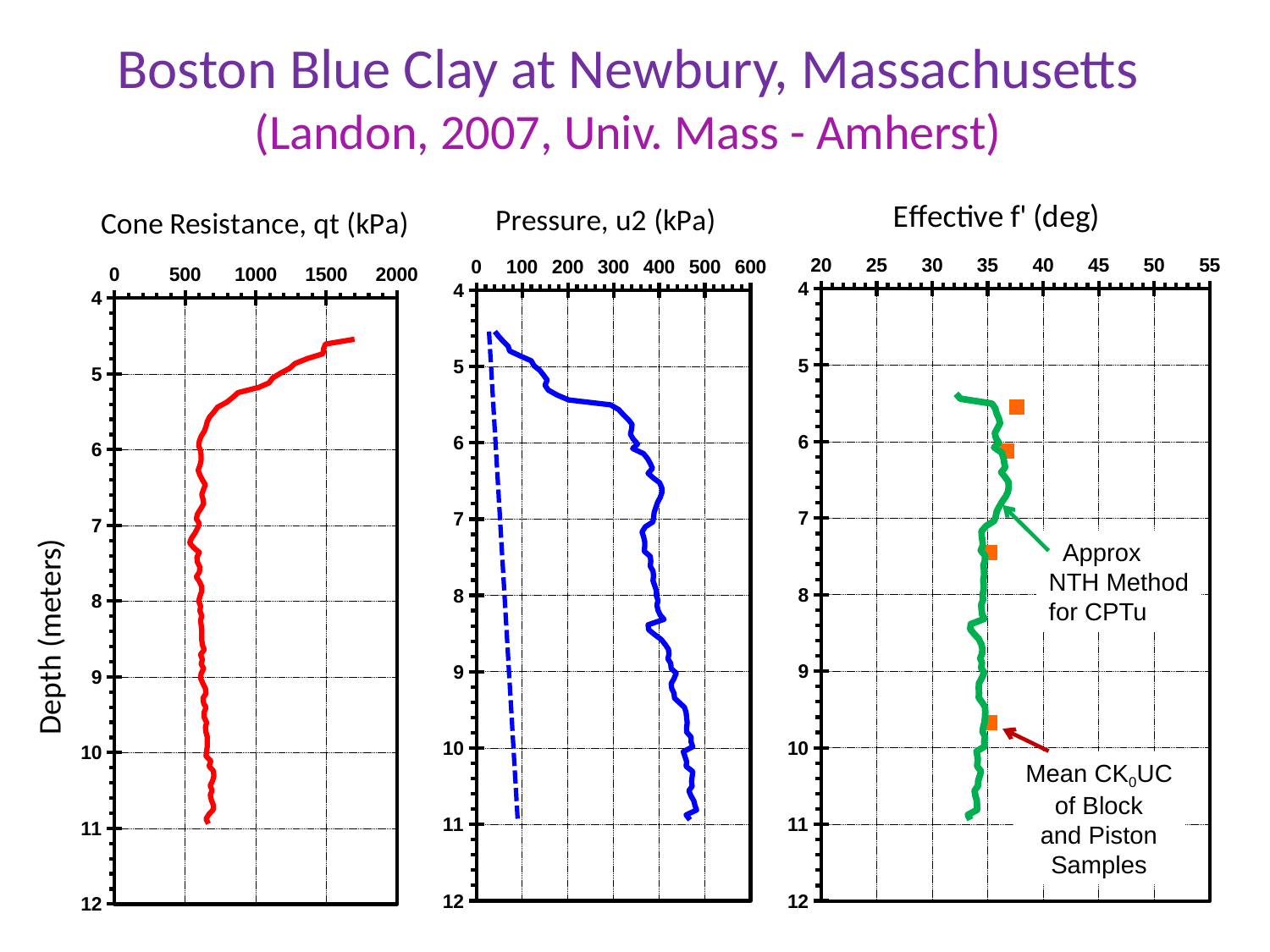
In the 'Pressure, u2 (kPa)' chart, does the solid-line pressure generally increase or decrease as depth increases from 5 meters to 11 meters? increase What is the label of the vertical axis shared by the charts? Depth (meters) In the 'Effective f' (deg)' chart, what is the maximum value shown on the horizontal axis? 55 In the 'Cone Resistance, qt (kPa)' chart, is the cone resistance at a depth of 4.5 meters greater or less than 1500? greater In the 'Cone Resistance, qt (kPa)' chart, is the cone resistance at a depth of 8 meters greater or less than 1000? less In the 'Pressure, u2 (kPa)' chart, is the dashed-line pressure at a depth of 10 meters greater or less than 200? less How many charts are shown on the slide? 3 What kind of chart is the 'Cone Resistance, qt (kPa)' chart? line chart In the 'Cone Resistance, qt (kPa)' chart, does the cone resistance increase or decrease as depth goes from 4.5 meters to 6 meters? decrease In the 'Effective f' (deg)' chart, how many orange square markers are plotted? 4